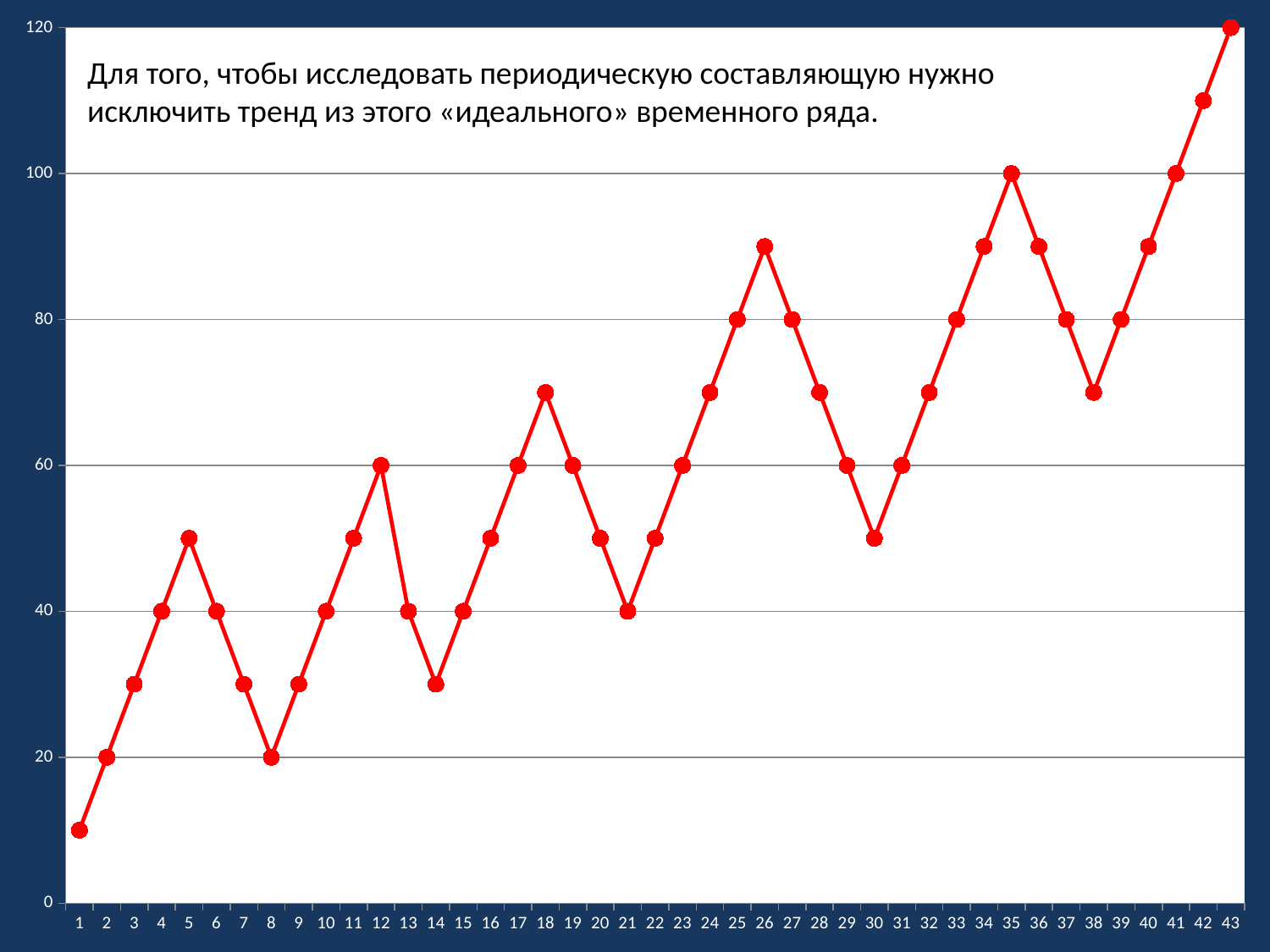
How many points are plotted along the x axis? 43 What is the value at point 35? 100 Which is larger, the value at point 12 or the value at point 8? point 12 Overall, do the values rise or fall from point 1 to point 43? rise What kind of chart is shown on the slide? line chart What is the value at point 12? 60 What is the value at point 43? 120 What is the value at point 8? 20 Is the value at point 26 greater or less than 80? greater What is the difference between the values at point 43 and point 35? 20 Which point has the lowest value? 1 Which point has the highest value? 43